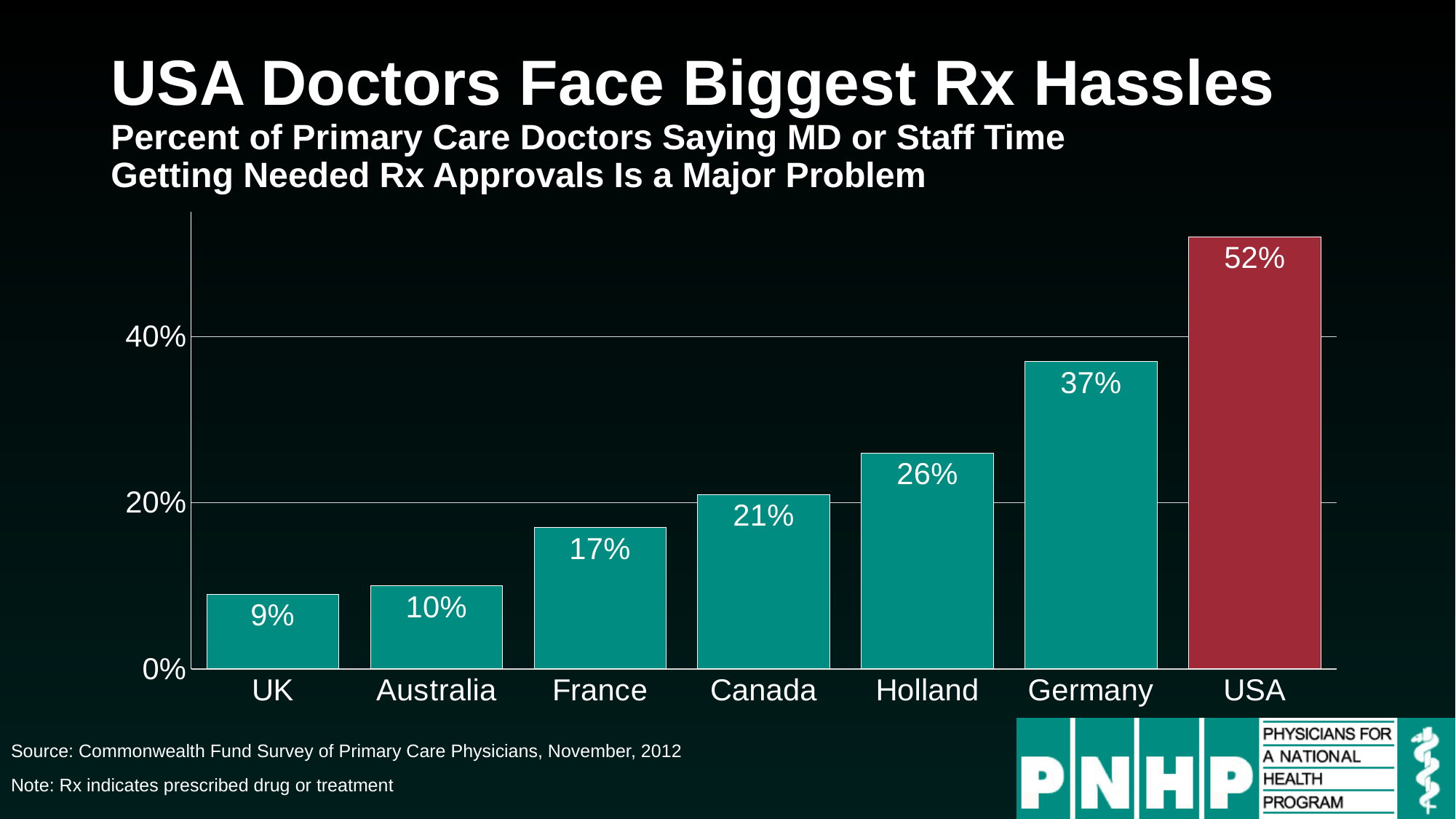
What is the difference between the Holland value and the France value? 9% Which country has the highest value on the chart? USA Which country has the lowest value on the chart? UK Is the value for Holland greater or less than 20%? greater Which is larger, the value for Australia or the value for France? France How many countries are shown on the chart? 7 What is the value shown for the UK? 9% What is the value shown for Germany? 37% Which bar is coloured differently (red) from the others? USA What is the difference between the USA value and the Germany value? 15% What percent of primary care doctors in Canada say getting needed Rx approvals is a major problem? 21% What kind of chart is shown on the slide? Bar chart